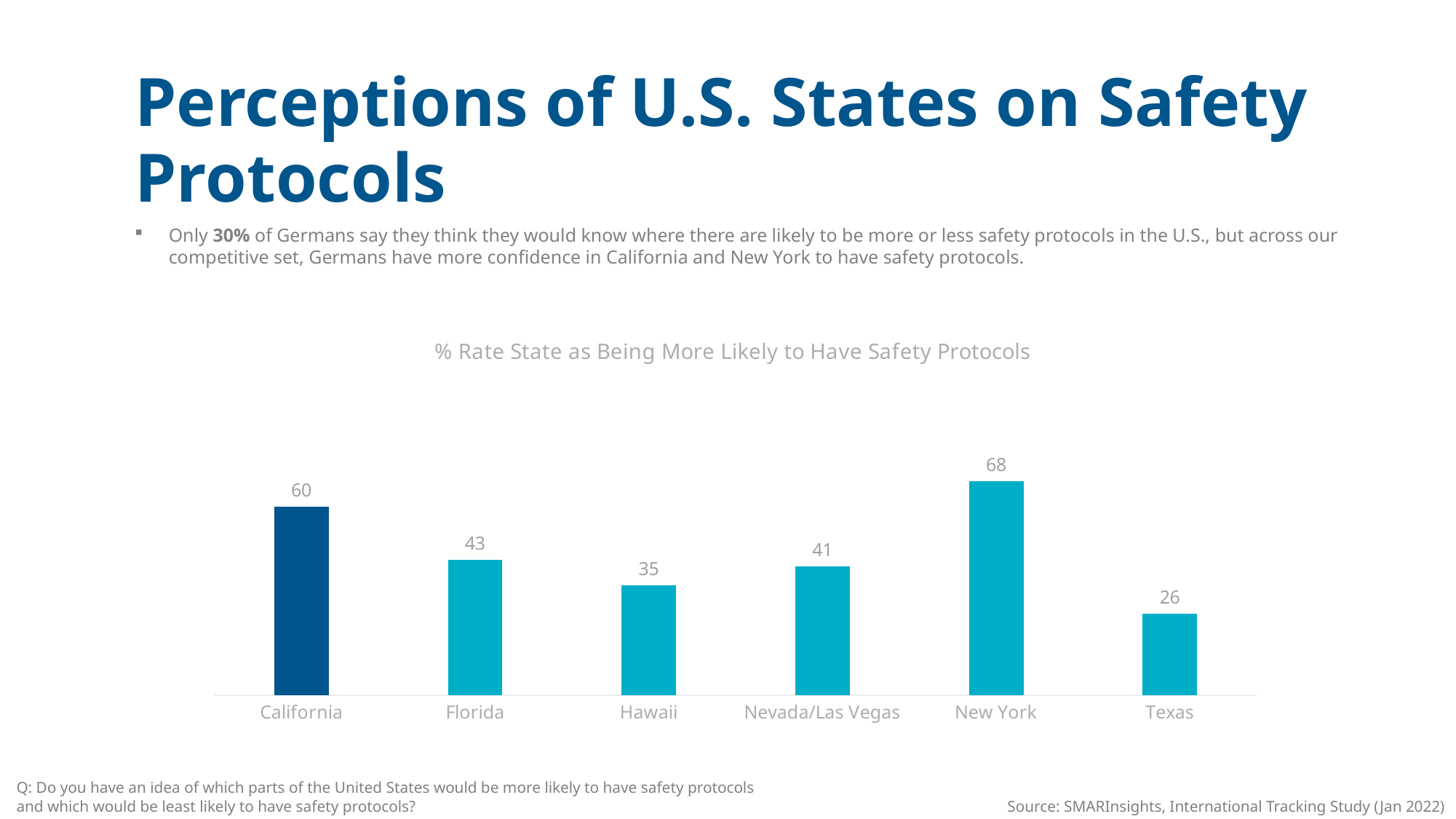
What kind of chart is shown on the slide? Bar chart Which state has the highest value? New York What is the difference between the values for Florida and Hawaii? 8 Which has a larger value, Florida or Nevada/Las Vegas? Florida What is the value for Texas? 26 How many states are shown in the chart? 6 What is the difference between the values for New York and California? 8 What is the value for New York? 68 What is the title of the chart? % Rate State as Being More Likely to Have Safety Protocols What is the value for California? 60 Which state has the lowest value? Texas What is the value for Nevada/Las Vegas? 41